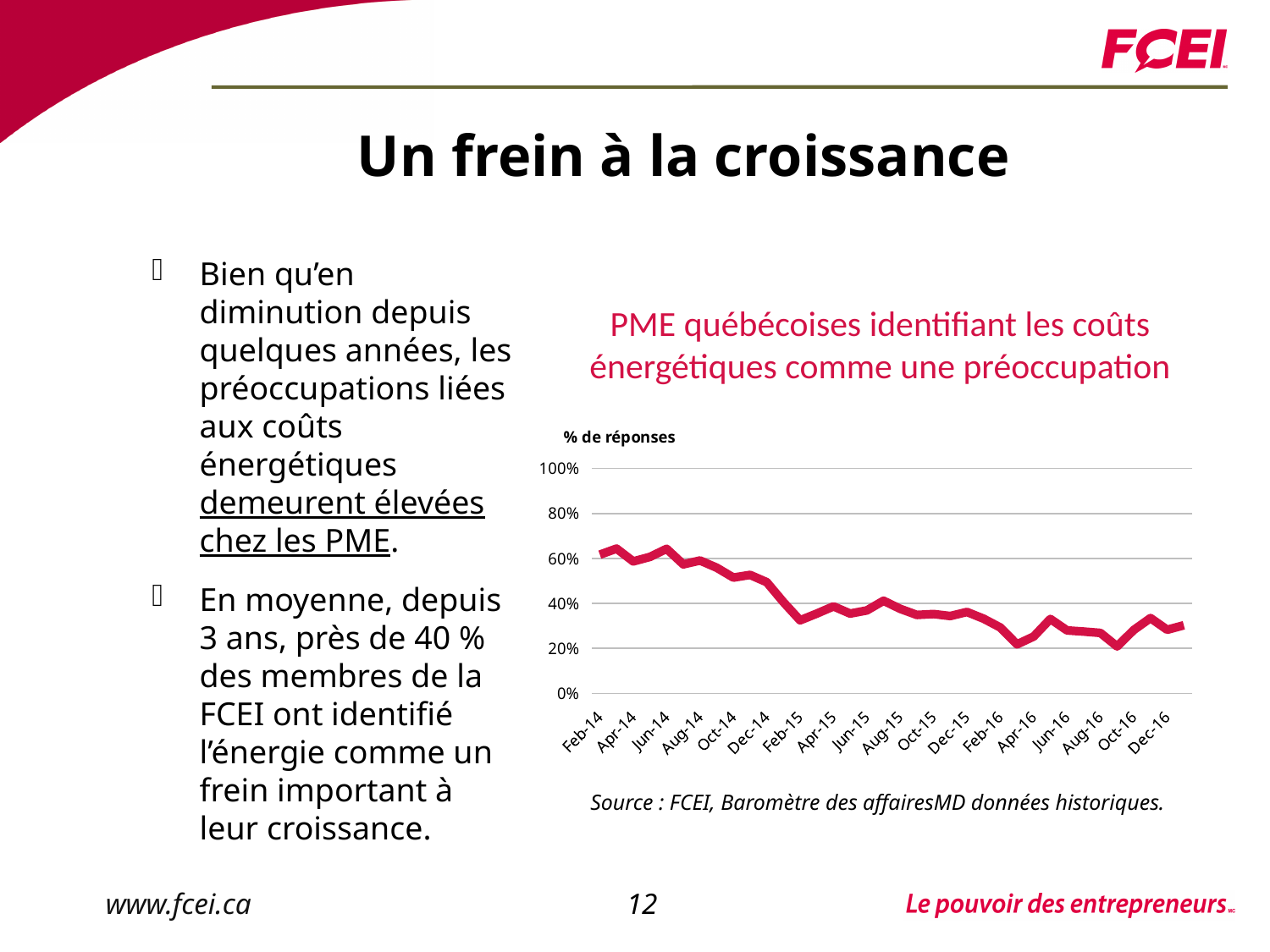
What is the title of the chart? PME québécoises identifiant les coûts énergétiques comme une préoccupation What kind of chart is shown on the slide? line chart Is the value for Dec-16 greater or less than 40%? less Is the value for Oct-16 greater or less than 20%? greater Do the values in the chart generally rise or fall from Feb-14 to Dec-16? fall Is the value for Apr-16 greater or less than 40%? less What label is shown on the vertical axis of the chart? % de réponses Which is larger, the value for Jun-14 or the value for Feb-15? Jun-14 Which is larger, the value for Feb-14 or the value for Dec-16? Feb-14